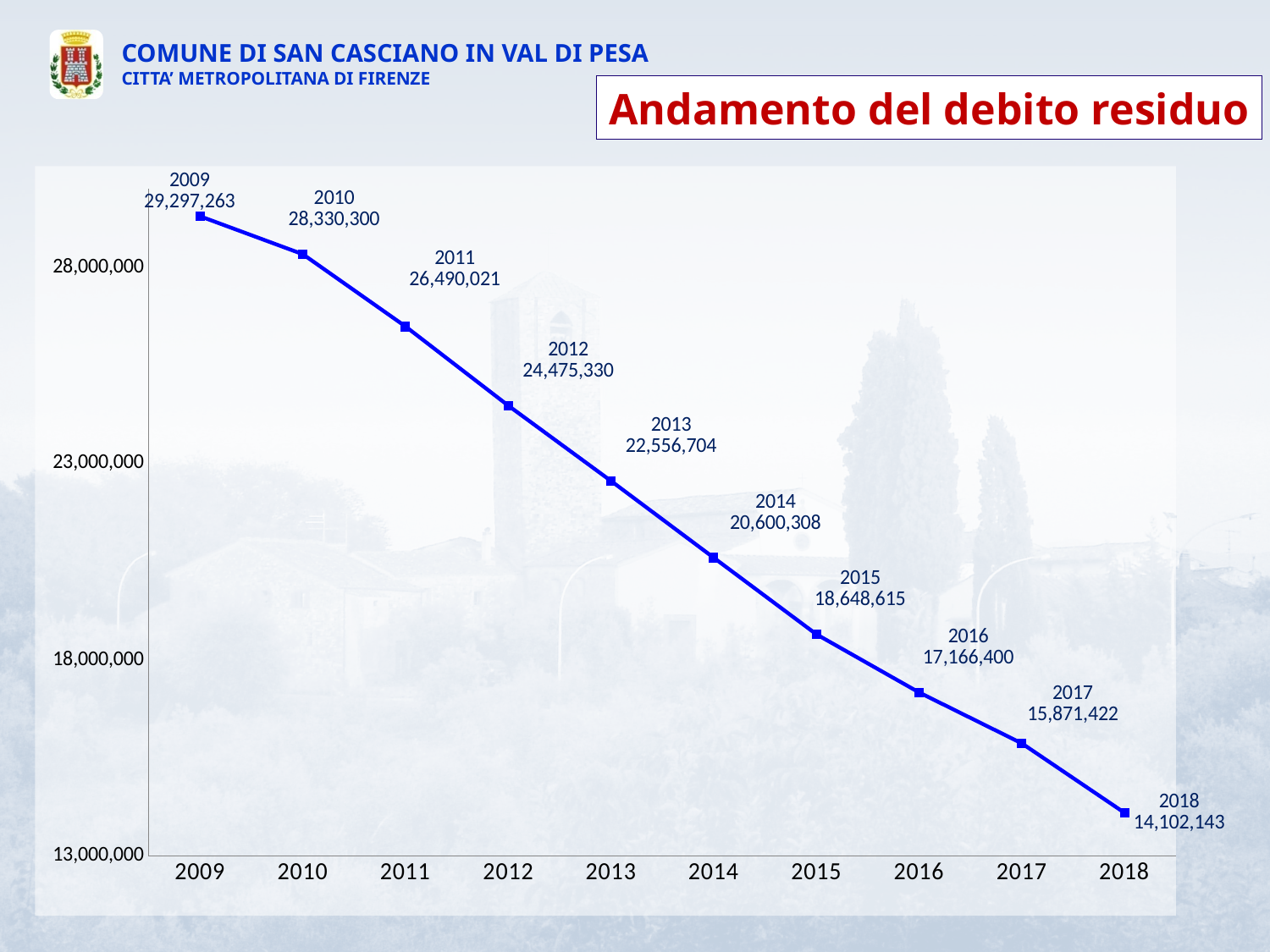
What is the residual debt value for 2009? 29,297,263 Is the residual debt for 2013 greater or less than 23,000,000? less Which year has the lowest residual debt? 2018 Which year has the highest residual debt? 2009 What is the residual debt value for 2018? 14,102,143 How many years are plotted on the chart? 10 What is the difference between the residual debt in 2017 and in 2018? 1,769,279 What kind of chart is shown on the slide? line chart What is the residual debt value for 2014? 20,600,308 What is the difference between the residual debt in 2009 and in 2010? 966,963 Which year has a larger residual debt, 2012 or 2015? 2012 Does the residual debt rise or fall from 2009 to 2018? fall